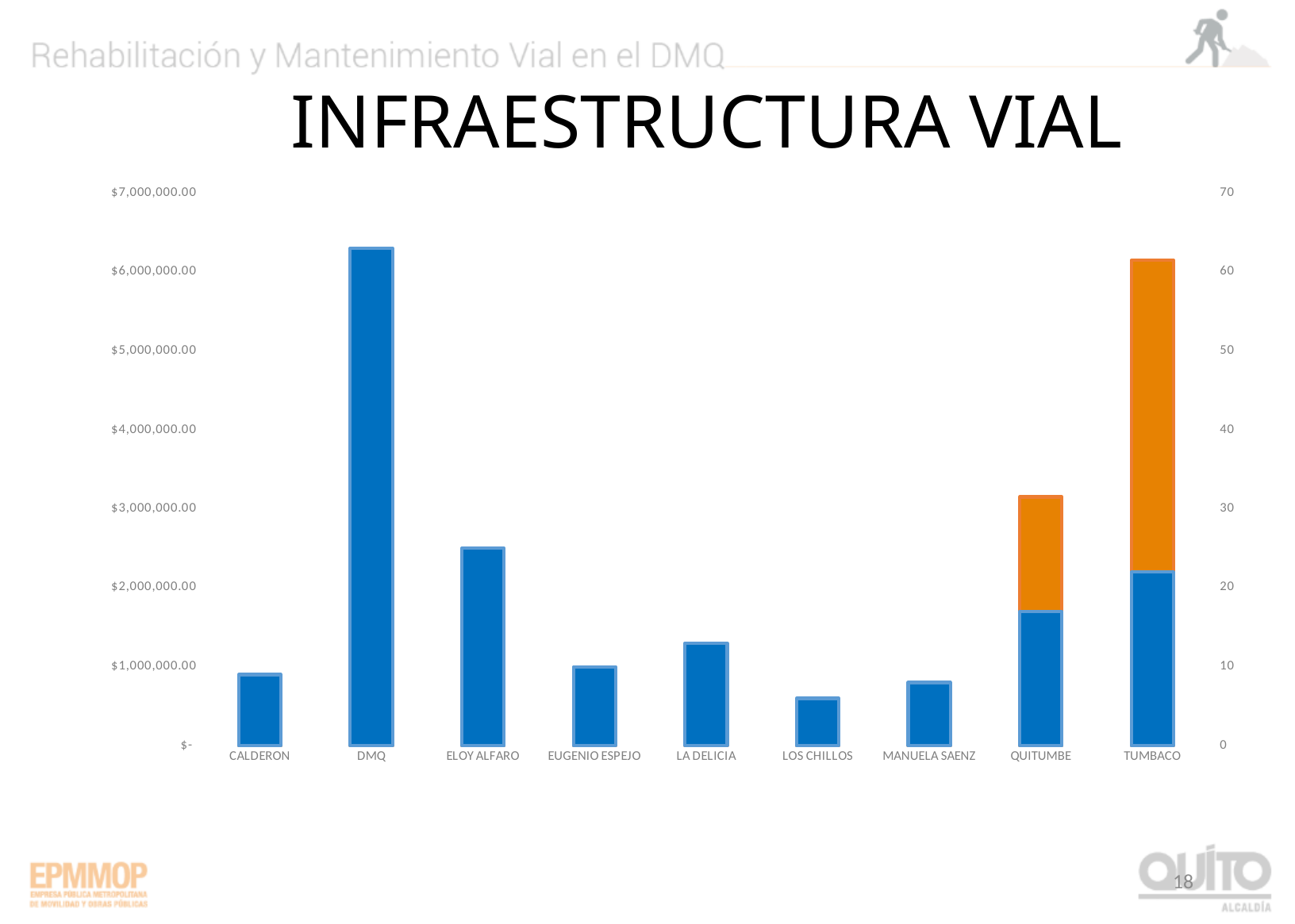
Is the total height of the stacked bar for TUMBACO greater or less than $5,000,000.00? greater What is the title of the chart on the slide? INFRAESTRUCTURA VIAL Which category has the shortest blue bar? LOS CHILLOS Which categories have an orange segment in their bar? QUITUMBE and TUMBACO Is the blue bar for LOS CHILLOS greater or less than $1,000,000.00? less Is the blue bar for LA DELICIA greater or less than $1,000,000.00? greater How many categories are shown on the x axis of the chart? 9 Which category has the tallest blue bar? DMQ Which is larger, the blue bar for DMQ or the blue bar for ELOY ALFARO? DMQ What kind of chart is shown on the slide? bar chart